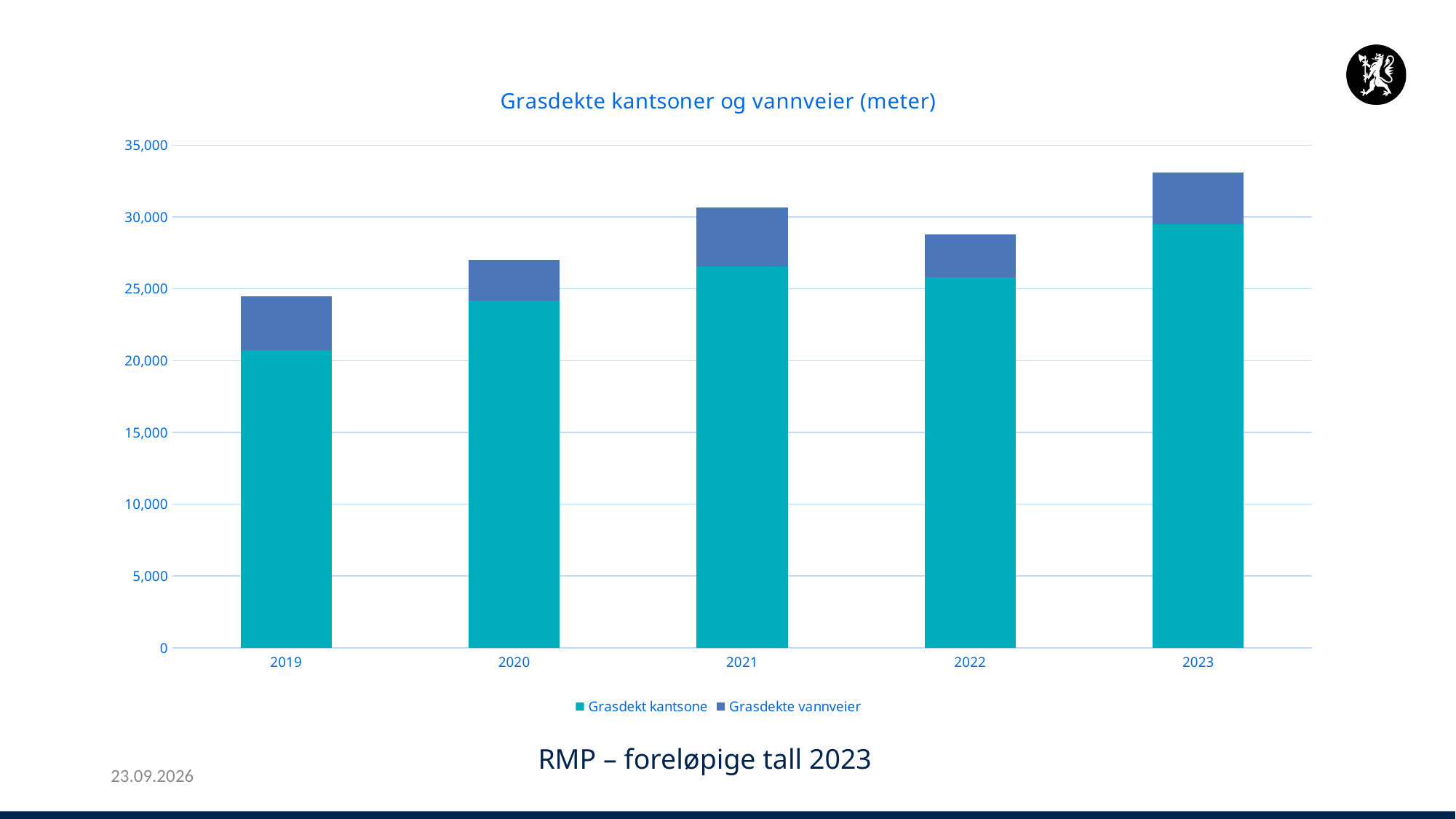
Is the value for Grasdekt kantsone in 2021 greater or less than 25,000? greater Is the total stacked bar for 2023 greater or less than 30,000? greater What is the title of the chart? Grasdekte kantsoner og vannveier (meter) Which series is shown in the darker blue colour at the top of each bar? Grasdekte vannveier How many series does the chart's legend list? 2 How many years are shown on the x axis of the chart? 5 Is the value for Grasdekt kantsone in 2019 greater or less than 25,000? less What kind of chart is shown on the slide? Stacked bar chart Between 2019 and 2021, do the total bar heights rise or fall? rise Which year has the larger total stacked bar, 2021 or 2022? 2021 Which year has the shortest stacked bar in total? 2019 Which year has the tallest stacked bar in total? 2023